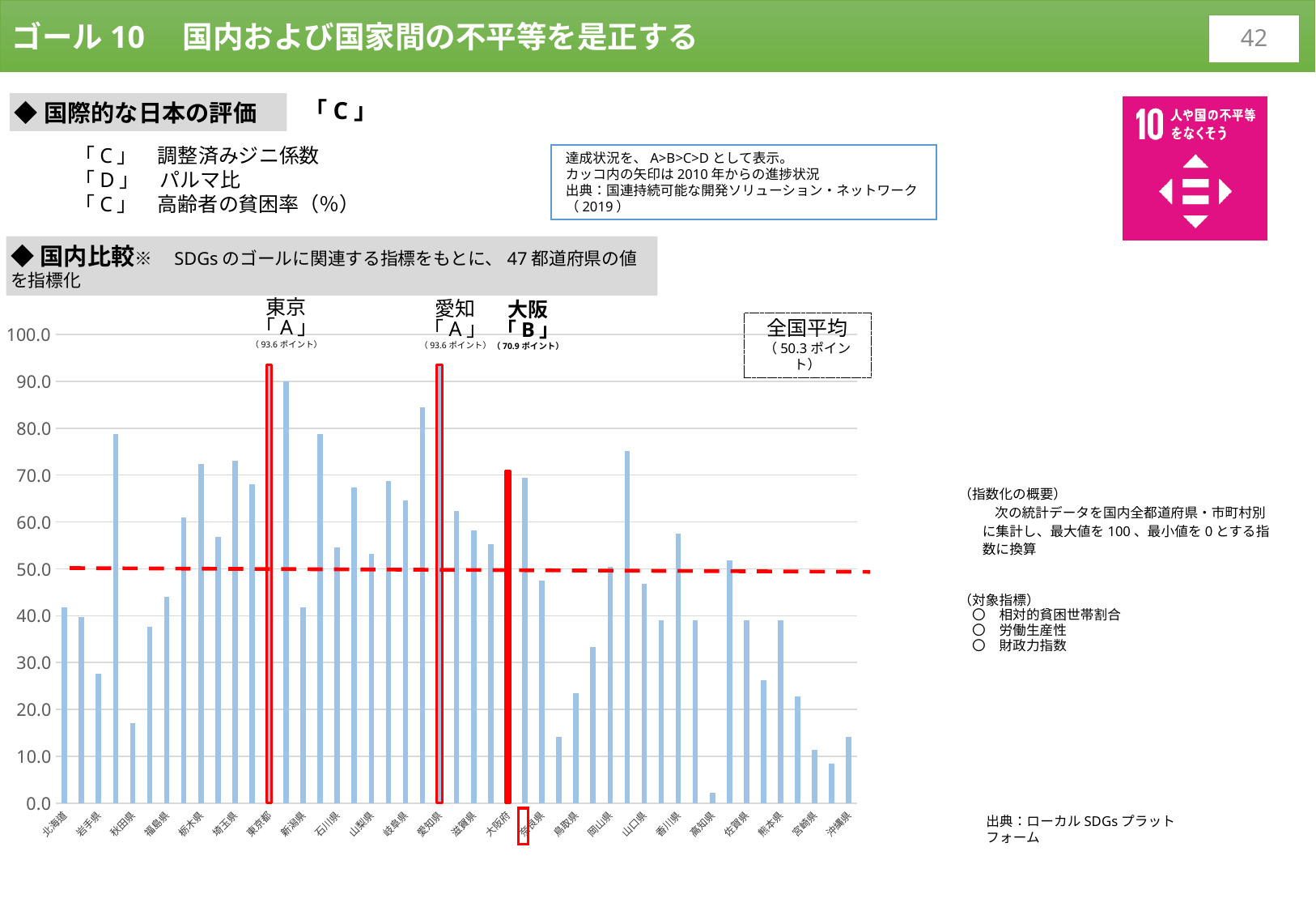
What is the difference between the values for 東京 and 大阪? 22.7 ポイント Is the value for 北海道 greater or less than 50.0? less Is the value for 秋田県 greater or less than 20.0? less How many prefectures are indexed in the chart? 47 What grade is given to 大阪 above its bar in the chart? 「B」 What kind of chart is shown on the slide? bar chart What is the 全国平均 (national average) value indicated on the chart? 50.3 ポイント What is the value shown for 東京 (Tokyo) in the bar chart? 93.6 ポイント Is the value for 高知県 greater or less than 10.0? less What is the value shown for 大阪 (Osaka) in the bar chart? 70.9 ポイント Which has the higher value, 東京 or 大阪? 東京